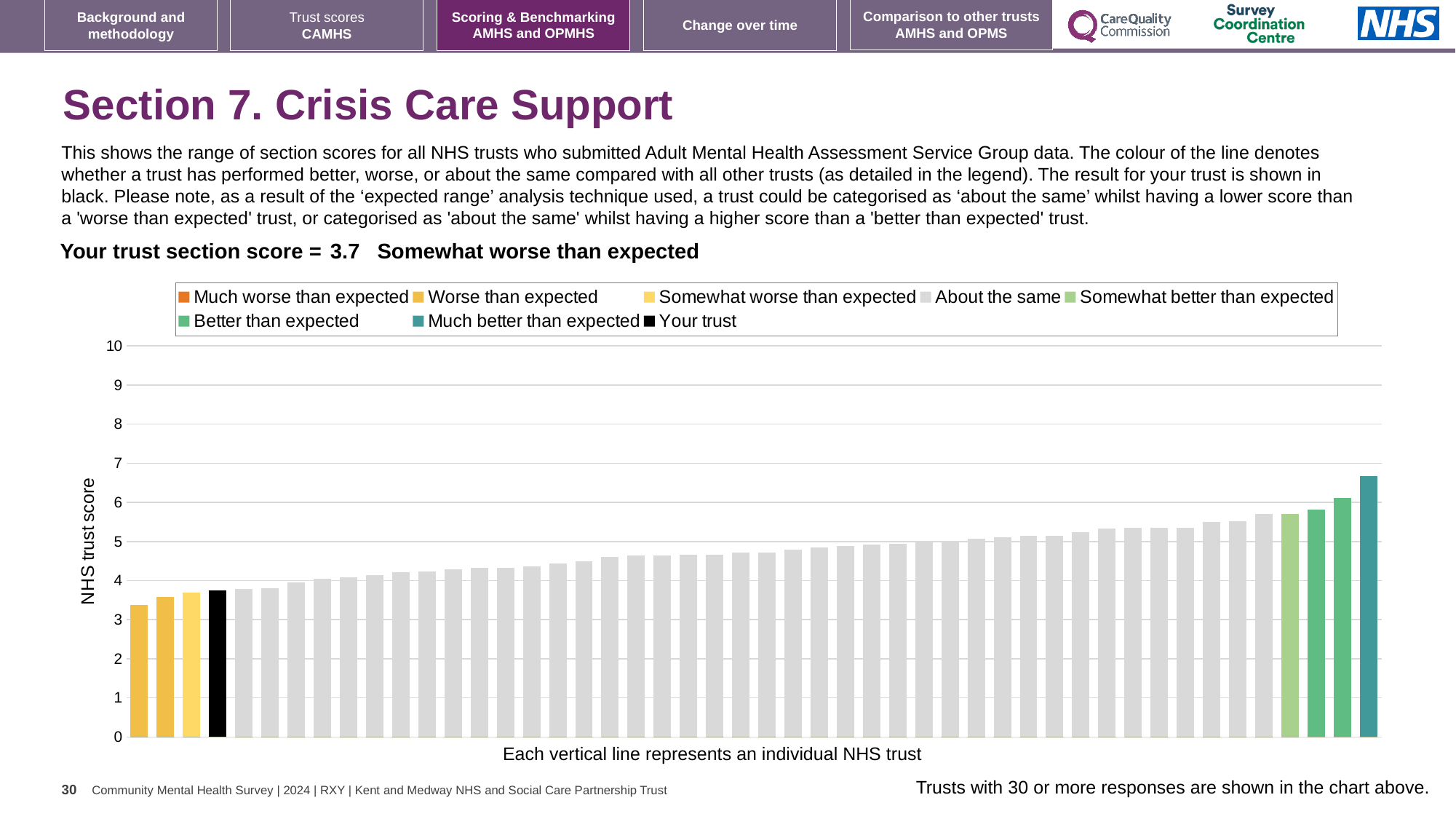
What is the section score for your trust shown on the slide? 3.7 Which performance category is your trust placed in for this section? Somewhat worse than expected Is your trust's section score greater or less than 4? less What is the label on the vertical axis of the chart? NHS trust score How many bars in the chart are coloured as 'Much better than expected'? 1 What kind of chart is shown on the slide? bar chart Do the bar values rise or fall from left to right across the chart? rise Is the value of the highest bar in the chart greater or less than 6? greater Is the value of the lowest bar in the chart greater or less than 4? less How many bars in the chart are coloured as 'Worse than expected'? 2 How many entries does the chart legend list? 8 What does each vertical line in the chart represent, according to the caption below the chart? an individual NHS trust